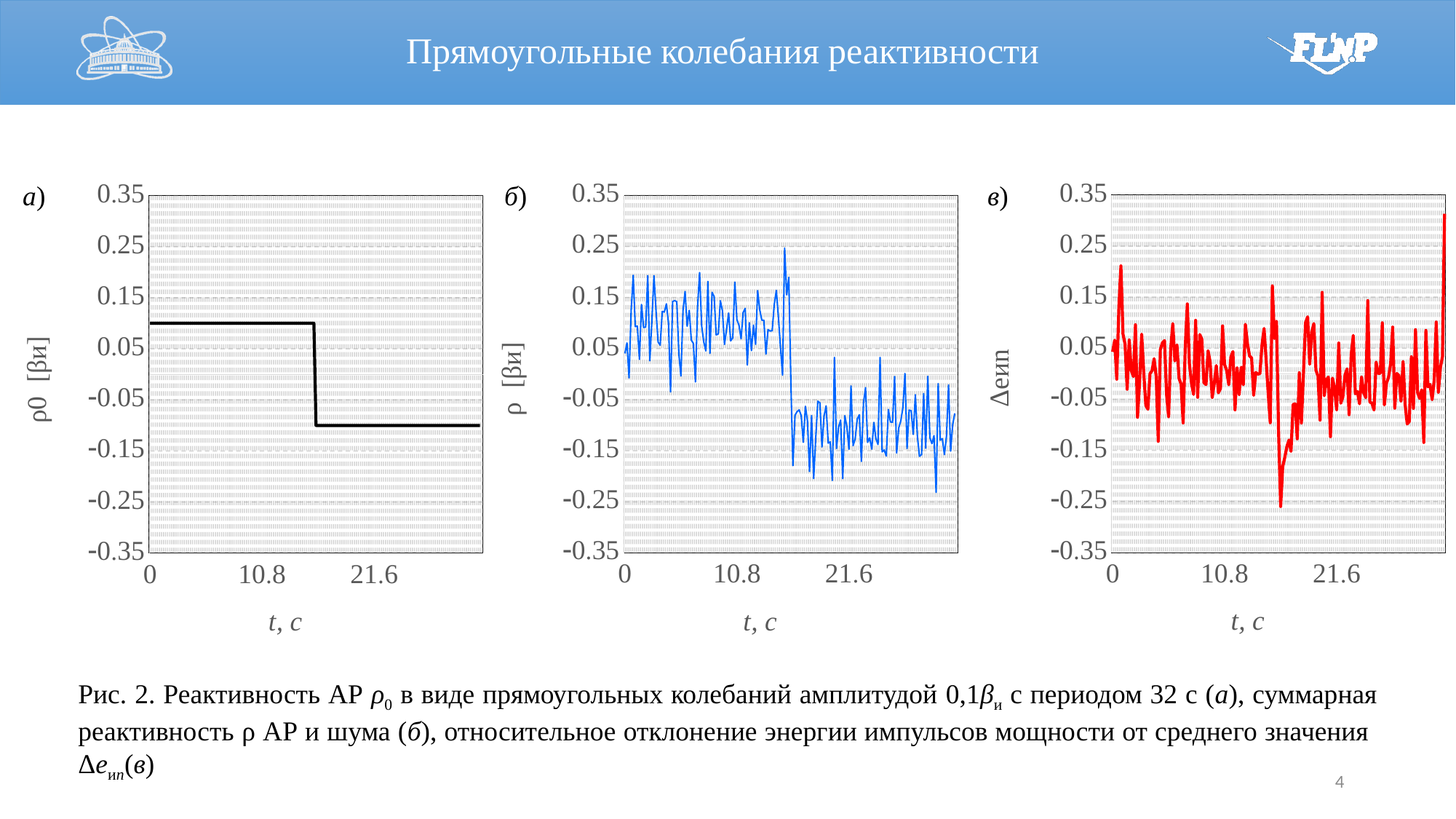
In chart б), are the values in the first half (before t ≈ 16) generally higher or lower than in the second half? higher What kind of chart is chart а) on the left of the slide? line chart In chart а), is the value of ρ0 at t = 21.6 greater or less than -0.05? less In chart а), is the value of ρ0 at t = 0 greater or less than 0.05? greater What colour is the line in chart в)? red What kind of chart is chart в) on the right of the slide? line chart In chart б), is the value of ρ at t = 0 greater or less than 0.25? less What is the x-axis label on all three charts? t, c In chart а), does the value of ρ0 rise or fall as t increases? fall How many charts are shown on the slide? 3